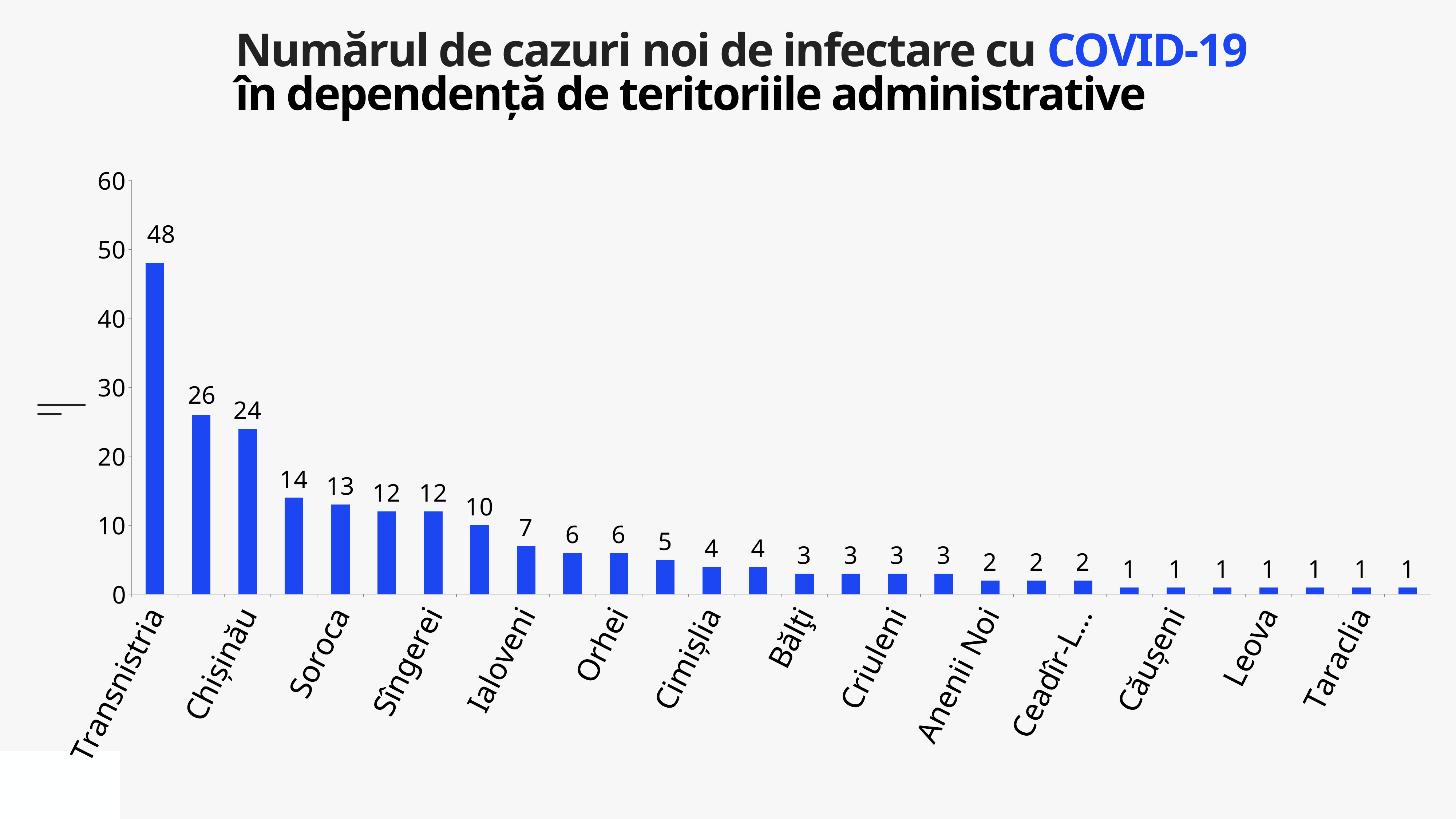
Which has a larger value, Transnistria or Chișinău? Transnistria What is the value shown for Sîngerei? 12 Is the value for Chișinău greater or less than 20? greater Do the values rise or fall from left to right along the x axis? fall What is the number of new COVID-19 cases for Transnistria? 48 Which territory has the highest number of new cases? Transnistria What is the difference between the values for Transnistria and Sîngerei? 36 What is the value shown for Taraclia? 1 What is the value shown for Criuleni? 3 What is the lowest value shown on the chart? 1 What is the value shown for Orhei? 6 What type of chart is shown on the slide? bar chart